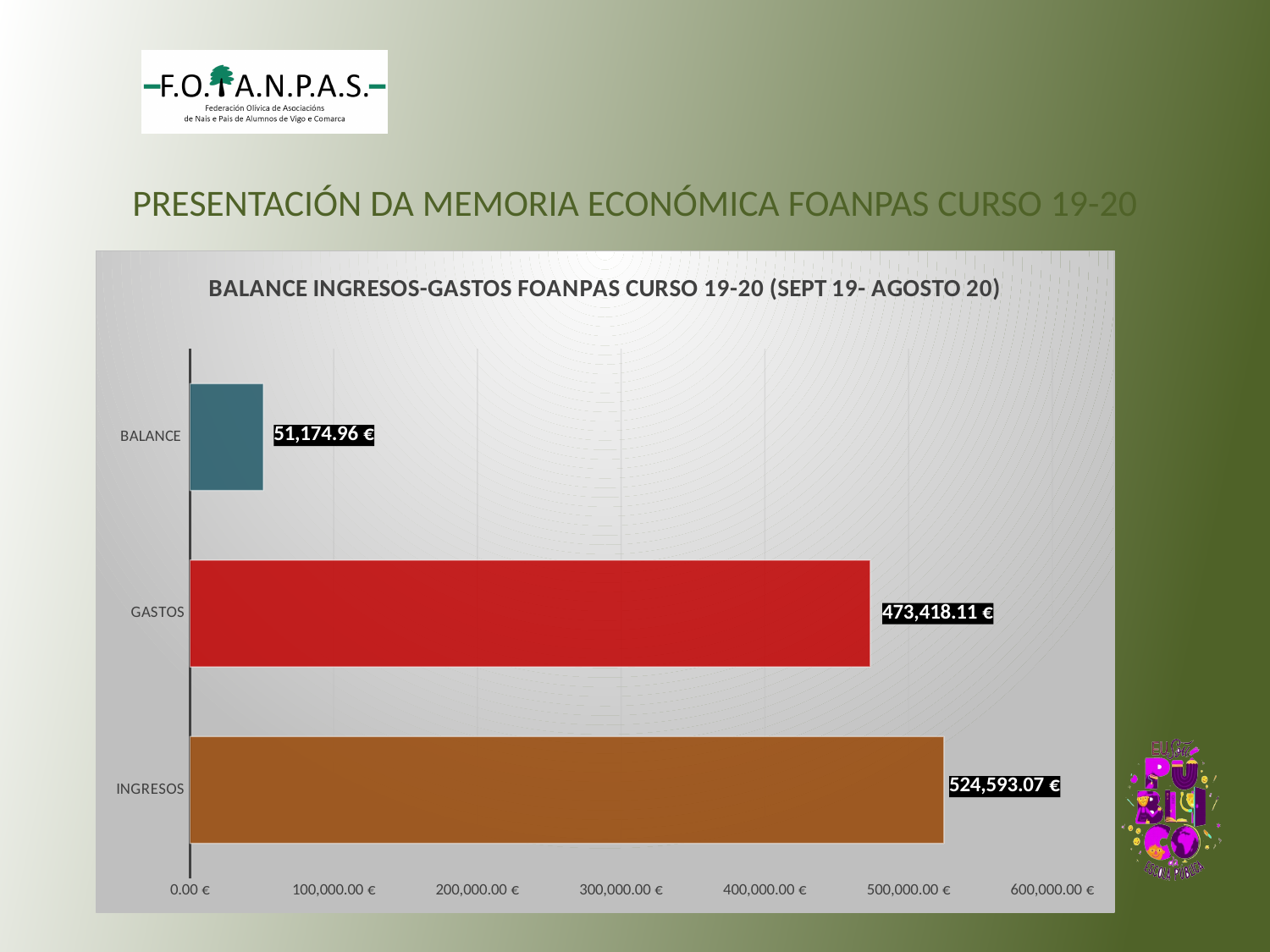
What is the value for GASTOS? 473,418.11 € Which category has the highest value? INGRESOS What is the title of the chart? BALANCE INGRESOS-GASTOS FOANPAS CURSO 19-20 (SEPT 19- AGOSTO 20) Which category has the lowest value? BALANCE Which is larger, INGRESOS or GASTOS? INGRESOS What is the difference between GASTOS and BALANCE? 422,243.15 € What is the value for BALANCE? 51,174.96 € What is the difference between INGRESOS and GASTOS? 51,174.96 € Is the value for GASTOS greater or less than 400,000.00 €? greater What kind of chart is shown on the slide? bar chart How many categories are shown in the chart? 3 What is the value for INGRESOS? 524,593.07 €